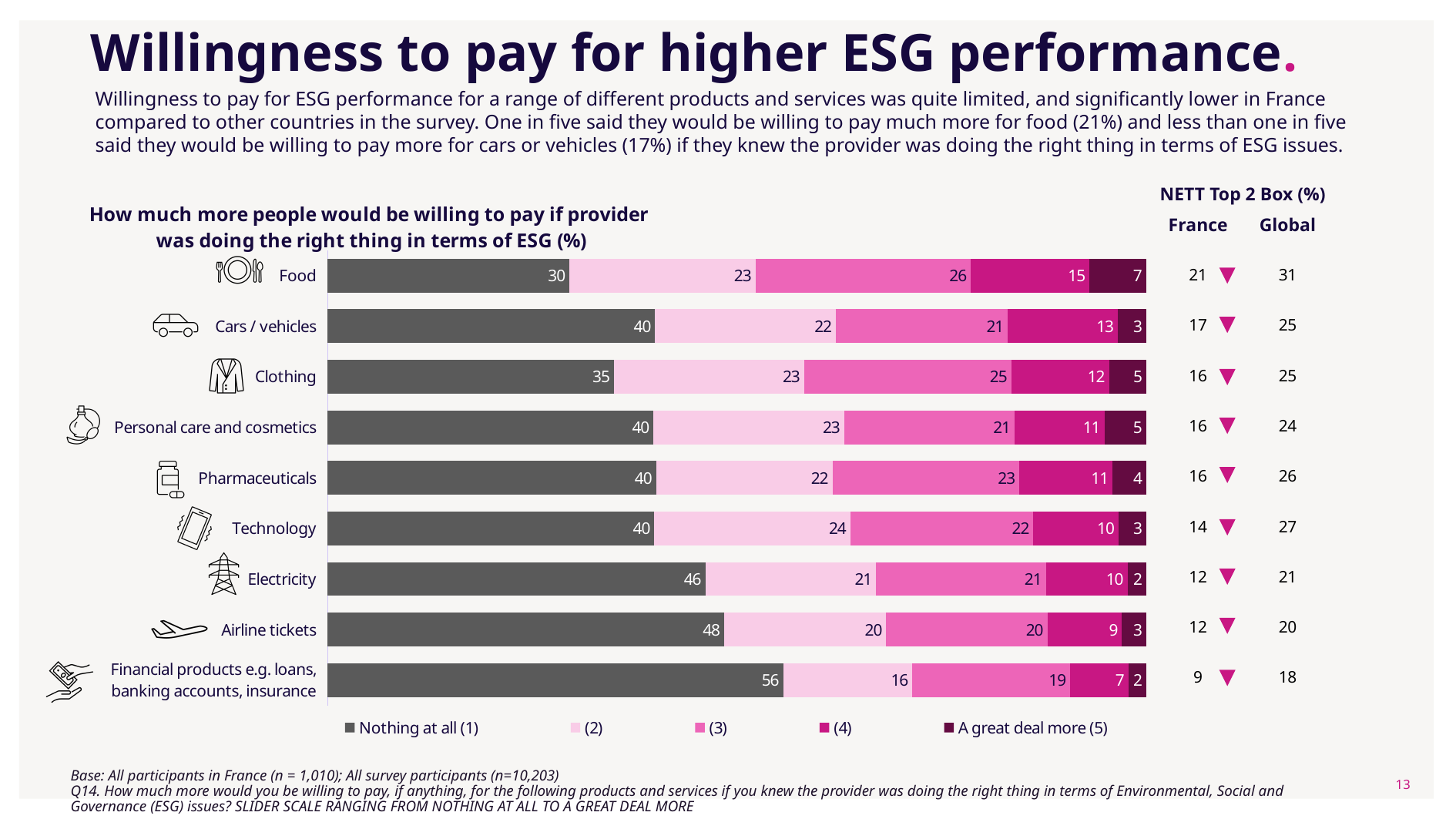
Which category has the lowest 'Nothing at all (1)' value? Food How many product/service categories are plotted in the chart? 9 What kind of chart is shown on the slide? Stacked bar chart What is the total of the stacked bar for Clothing? 100 What is the 'A great deal more (5)' value for Food? 7 Which has the larger '(4)' value, Food or Cars / vehicles? Food What is the '(2)' value for Technology? 24 Which category has the highest 'Nothing at all (1)' value? Financial products e.g. loans, banking accounts, insurance How many series does the chart legend list? 5 What is the '(3)' value for Pharmaceuticals? 23 What is the 'Nothing at all (1)' value for Food? 30 What is the difference between the 'Nothing at all (1)' values for Financial products and Food? 26